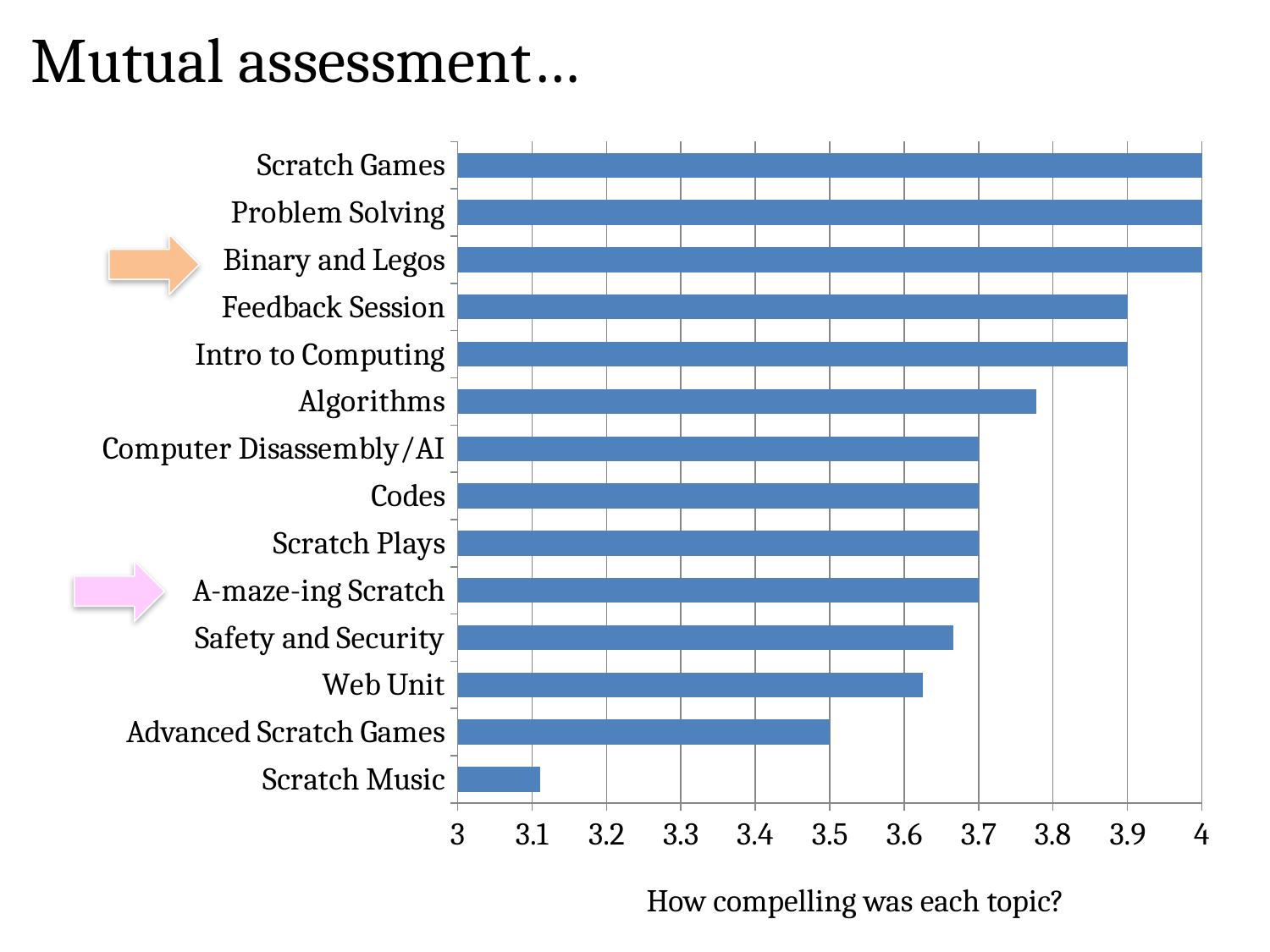
Is the value for Scratch Music greater or less than 3.2? less What is the value for Scratch Games? 4 What is the value for Feedback Session? 3.9 Is the value for Algorithms greater or less than 3.7? greater Which topic has the lowest value on the chart? Scratch Music What is the value for Codes? 3.7 How many topics are listed on the chart? 14 What is the x-axis label of the chart? How compelling was each topic? What is the difference between the value for Binary and Legos and the value for Advanced Scratch Games? 0.5 What kind of chart is shown on the slide? bar chart Which is larger, the value for Web Unit or the value for Advanced Scratch Games? Web Unit What is the value for Advanced Scratch Games? 3.5